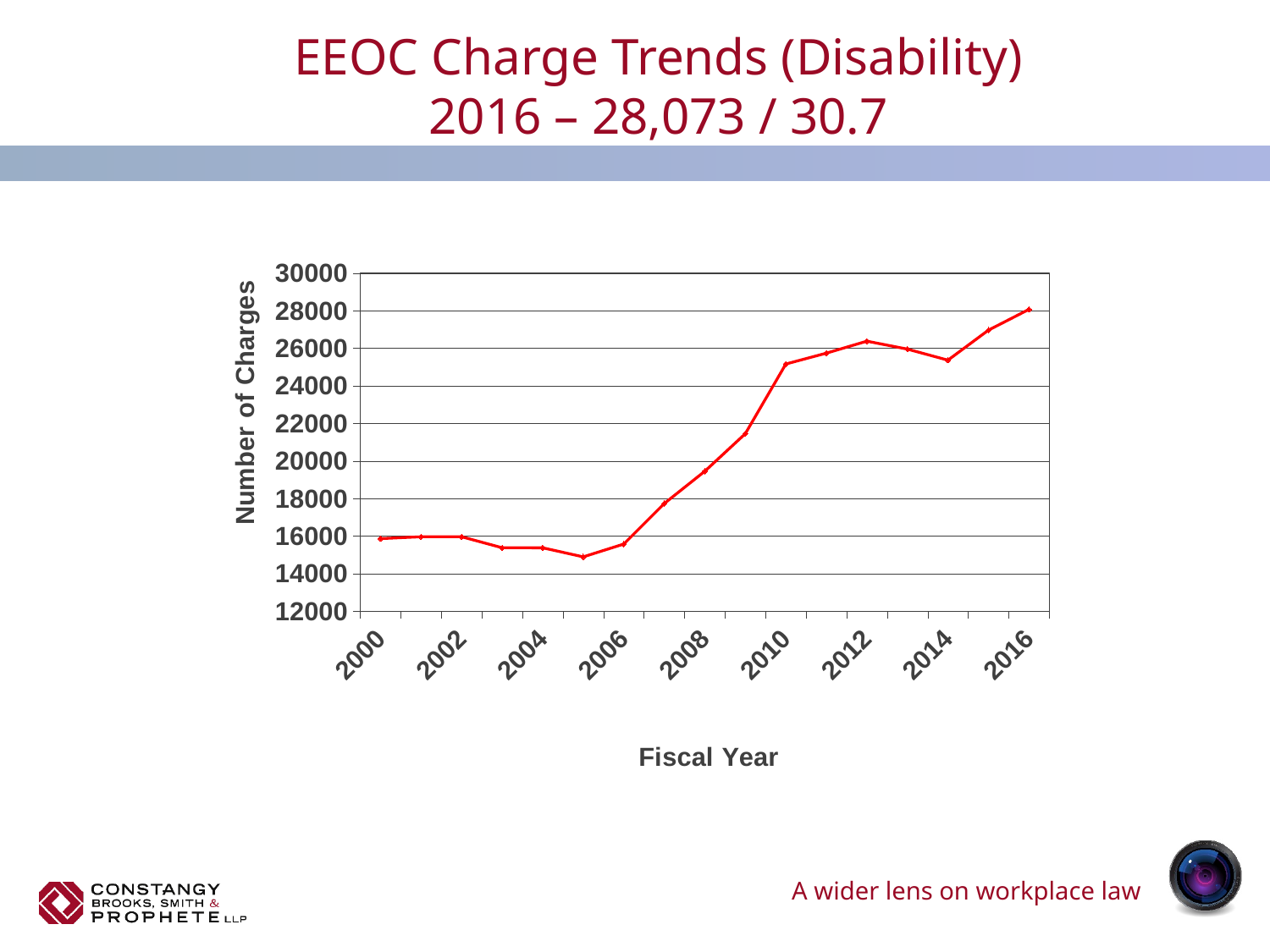
What is the label of the vertical axis? Number of Charges Which year has more charges, 2006 or 2010? 2010 What kind of chart is shown on the slide? line chart Is the number of charges for 2005 greater or less than 16000? less Which fiscal year has the lowest number of charges? 2005 Is the number of charges for 2010 greater or less than 24000? greater Which fiscal year has the highest number of charges? 2016 According to the slide, how many charges were there in 2016? 28,073 Is the number of charges for 2014 greater or less than 26000? less What is the title of the chart on the slide? EEOC Charge Trends (Disability) 2016 – 28,073 / 30.7 Overall, do the number of charges rise or fall from 2000 to 2016? rise How many data points are plotted on the line? 17